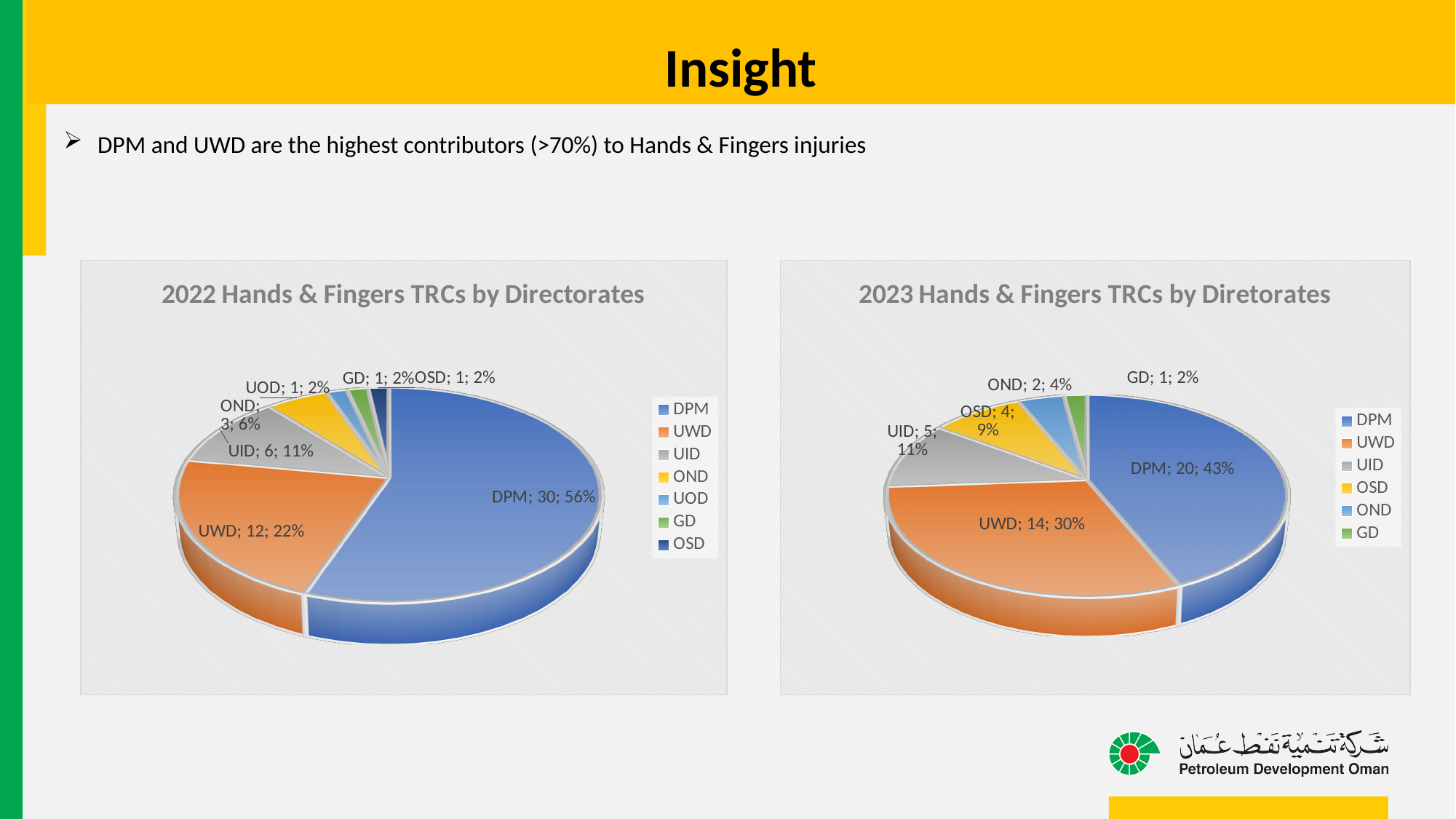
In the 2022 Hands & Fingers TRCs by Directorates chart, what is the difference in TRCs between DPM and UWD? 18 In the 2023 Hands & Fingers TRCs by Diretorates chart, what share of the pie does DPM represent? 43% In the 2022 Hands & Fingers TRCs by Directorates chart, what share of the pie does UWD represent? 22% In the 2023 Hands & Fingers TRCs by Diretorates chart, how many TRCs does UWD account for? 14 In the 2022 Hands & Fingers TRCs by Directorates chart, how many TRCs does DPM account for? 30 How many entries does the legend of the 2022 Hands & Fingers TRCs by Directorates chart list? 7 In the 2023 Hands & Fingers TRCs by Diretorates chart, which directorate has the smallest slice? GD What type of chart is the 2022 Hands & Fingers TRCs by Directorates chart? Pie chart How many categories are shown in the 2023 Hands & Fingers TRCs by Diretorates chart? 6 In the 2023 Hands & Fingers TRCs by Diretorates chart, what colour is the OSD slice? Yellow In the 2023 Hands & Fingers TRCs by Diretorates chart, which is larger, the UID slice or the OSD slice? UID In the 2022 Hands & Fingers TRCs by Directorates chart, which directorate has the largest slice? DPM